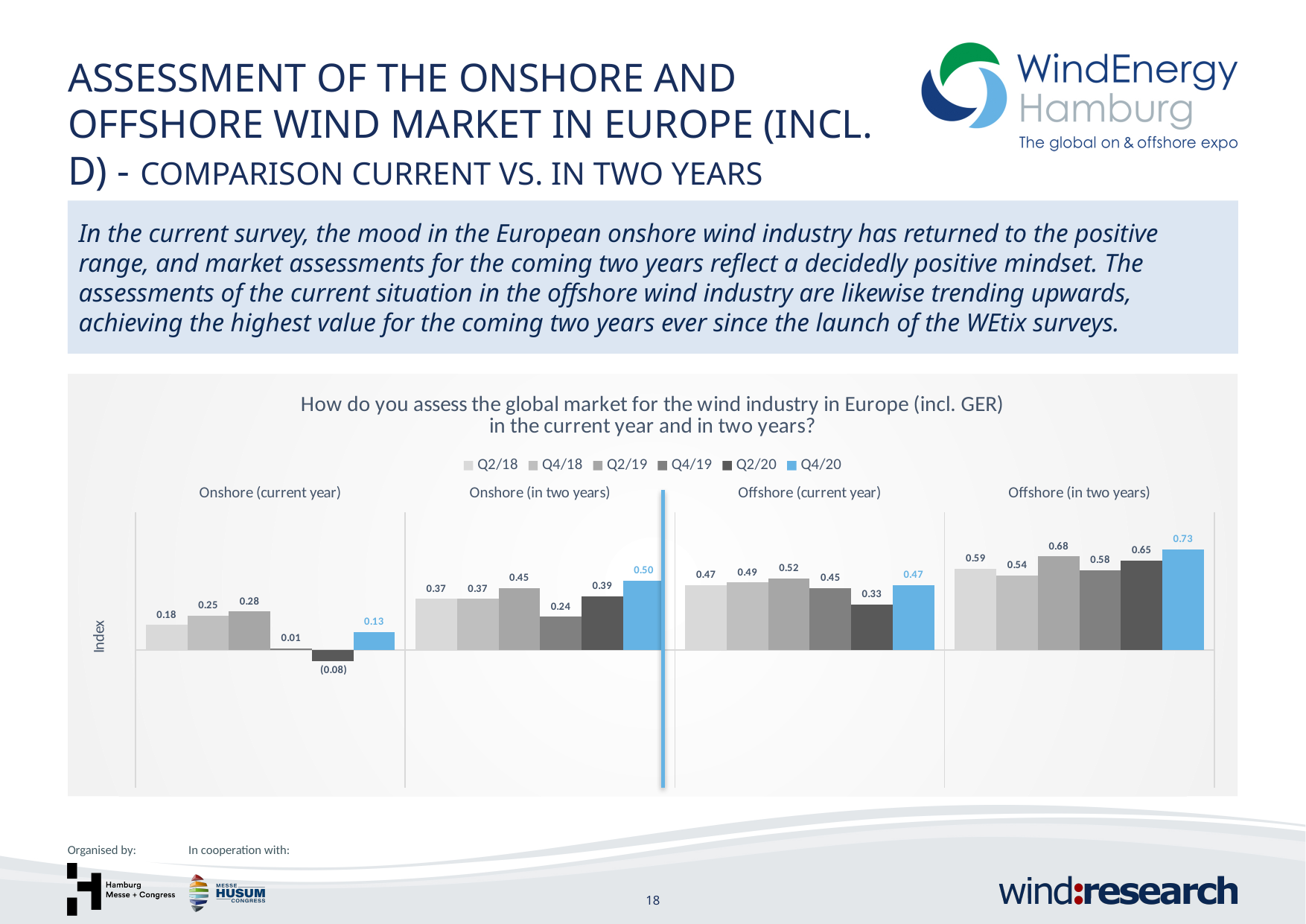
What is the difference between the Q2/19 and Q2/20 values for Offshore (current year)? 0.19 Which is larger: the Q2/19 value for Offshore (in two years) or the Q2/20 value for Offshore (in two years)? Q2/19 (0.68) Which survey wave has the lowest value in the Onshore (in two years) group? Q4/19 What is the Q2/20 value for Onshore (current year)? (0.08) What kind of chart is shown on the slide? Bar chart How many category groups are shown on the x axis? 4 Which series is shown in blue in the legend? Q4/20 Which survey wave has the highest value in the Offshore (current year) group? Q2/19 How many series does the legend list? 6 What is the difference between the Q4/20 and Q2/20 values for Onshore (current year)? 0.21 What is the Q4/19 value for Onshore (in two years)? 0.24 What is the Q4/20 value for Offshore (in two years)? 0.73